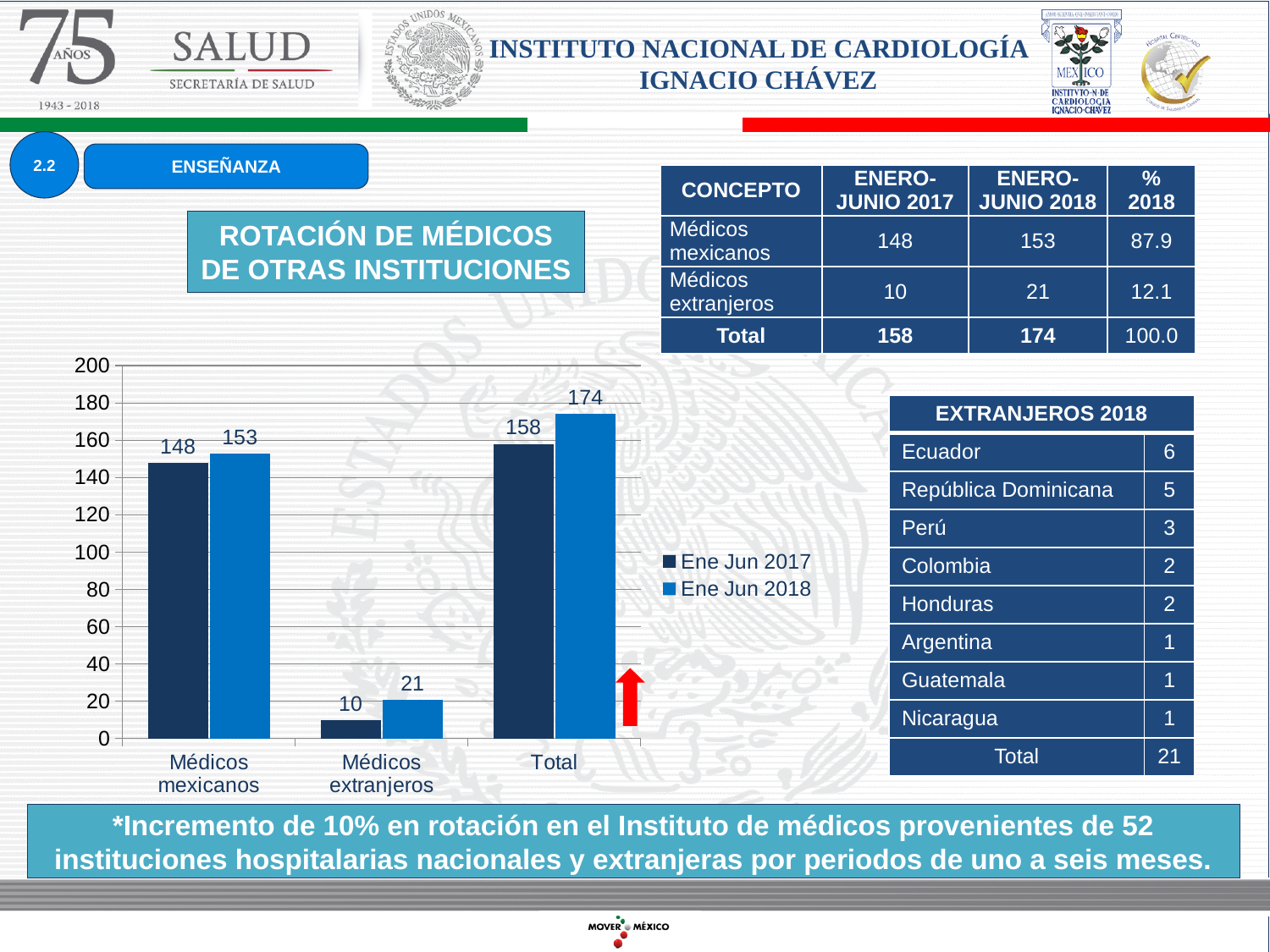
Which category has the highest value in the Ene Jun 2018 series? Total How many categories are shown on the x axis of the chart? 3 What is the value for Total in the Ene Jun 2018 series? 174 Which is larger for Médicos mexicanos: the Ene Jun 2017 value or the Ene Jun 2018 value? Ene Jun 2018 What is the difference between the Ene Jun 2018 and Ene Jun 2017 values for Total? 16 What is the value for Total in the Ene Jun 2017 series? 158 How many series does the chart legend list? 2 What is the difference between the Ene Jun 2018 and Ene Jun 2017 values for Médicos extranjeros? 11 Which category has the lowest value in the Ene Jun 2017 series? Médicos extranjeros What is the value for Médicos mexicanos in the Ene Jun 2017 series? 148 What kind of chart is shown on the slide? Bar chart What is the value for Médicos extranjeros in the Ene Jun 2018 series? 21